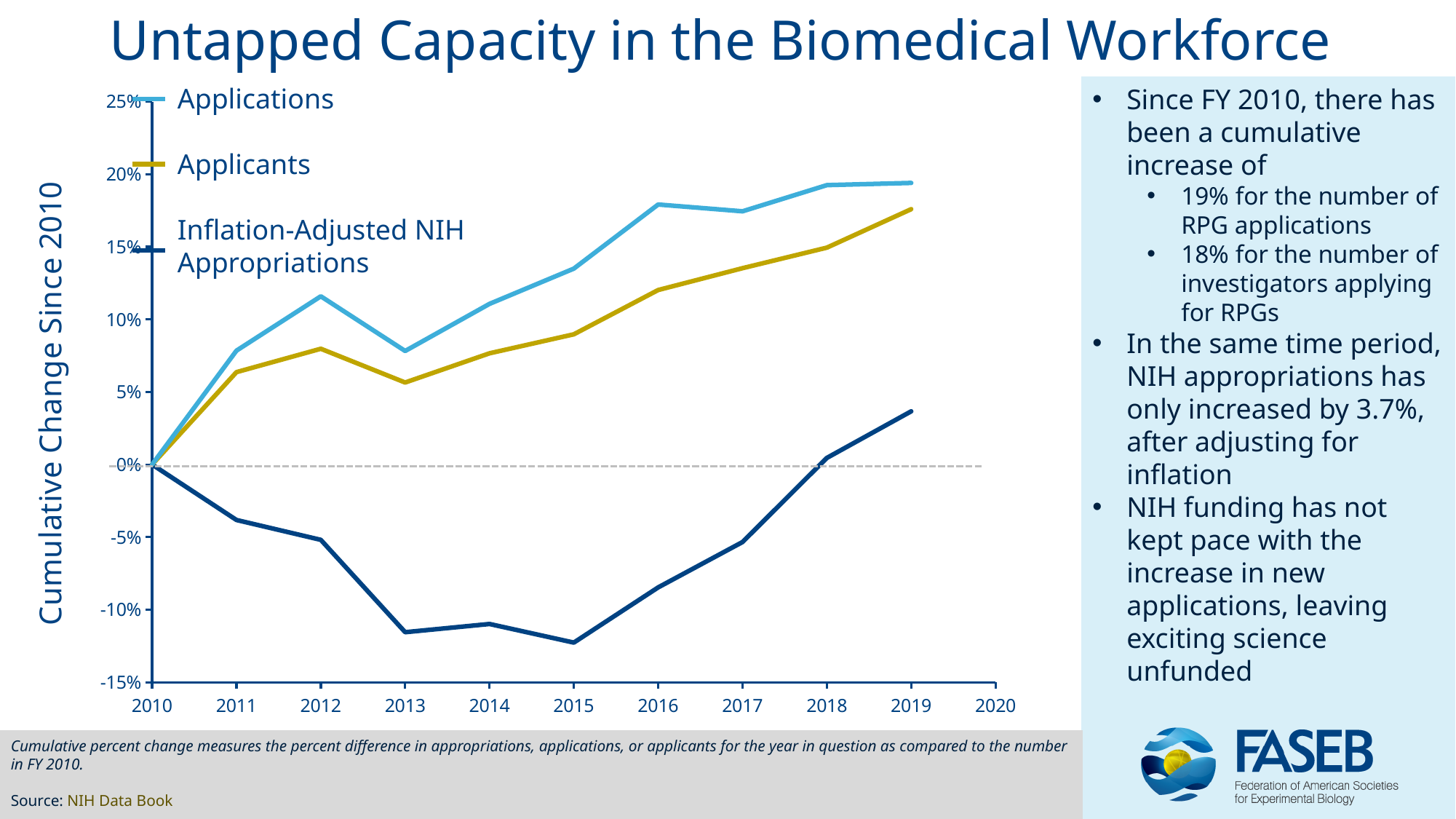
Which series has the highest value in 2019? Applications What kind of chart is shown on the slide? Line chart Is the value for Applicants in 2012 greater or less than 5%? greater Does the Inflation-Adjusted NIH Appropriations line rise or fall from 2015 to 2019? Rise Which series has the lowest value in 2019? Inflation-Adjusted NIH Appropriations In 2016, which is larger: Applications or Applicants? Applications Is the value for Inflation-Adjusted NIH Appropriations in 2015 greater or less than -10%? less What is the label on the vertical axis of the chart? Cumulative Change Since 2010 Is the value for Applications in 2019 greater or less than 15%? greater How many years from 2010 to 2019 have plotted data points? 10 How many series does the chart's legend list? 3 What is the value of all three series in 2010? 0%